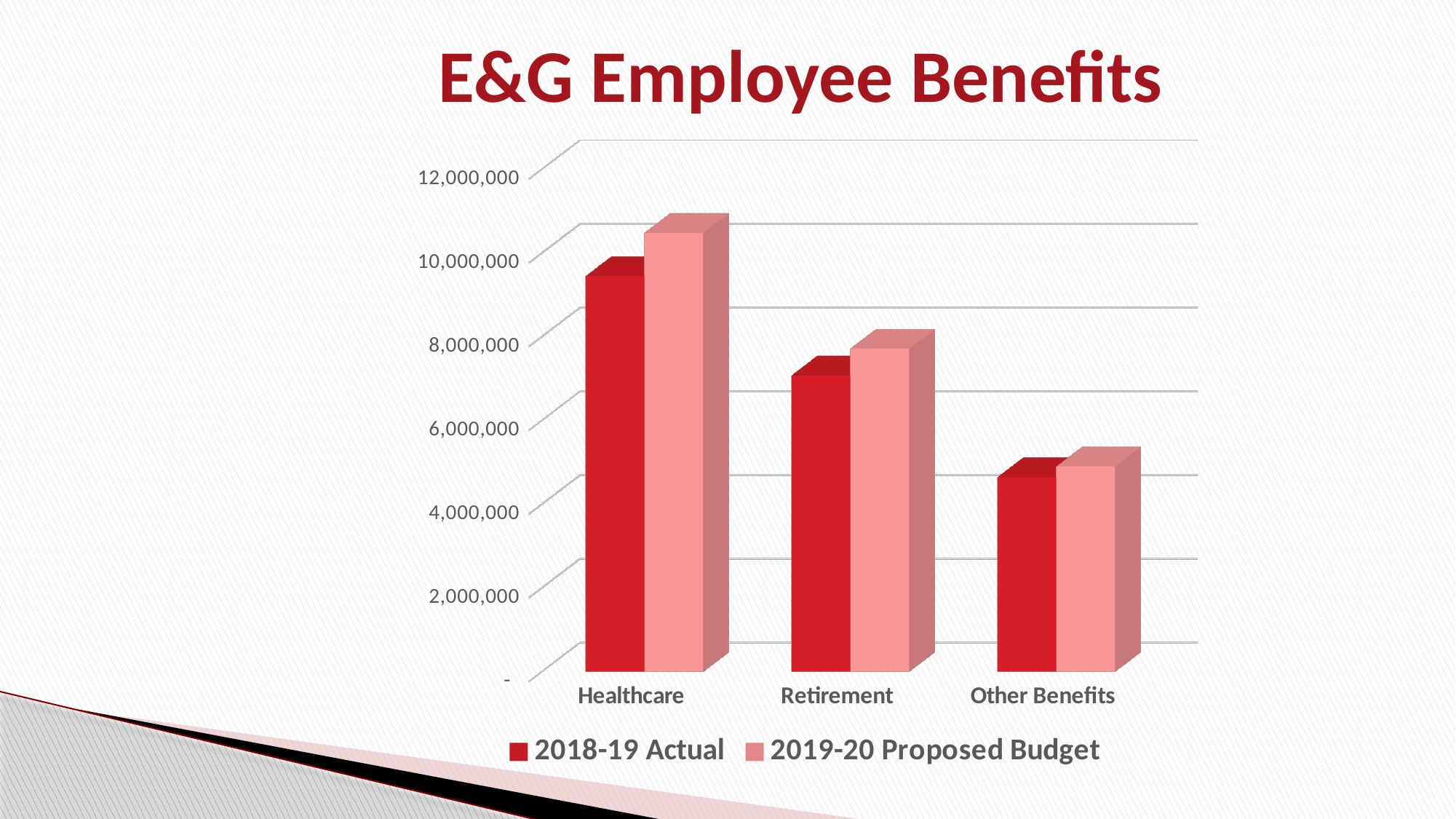
What kind of chart is shown on the slide? Bar chart Which category has the lowest values? Other Benefits What is the title of the chart? E&G Employee Benefits Is the 2018-19 Actual value for Retirement greater or less than 6,000,000? greater Which category has the highest values? Healthcare How many categories are shown on the x axis? 3 Do the values rise or fall moving from Healthcare to Other Benefits along the x axis? fall Is the 2018-19 Actual value for Healthcare greater or less than 8,000,000? greater How many series does the legend list? 2 Is the 2019-20 Proposed Budget value for Other Benefits greater or less than 6,000,000? less For Healthcare, which is larger: the 2018-19 Actual or the 2019-20 Proposed Budget? 2019-20 Proposed Budget